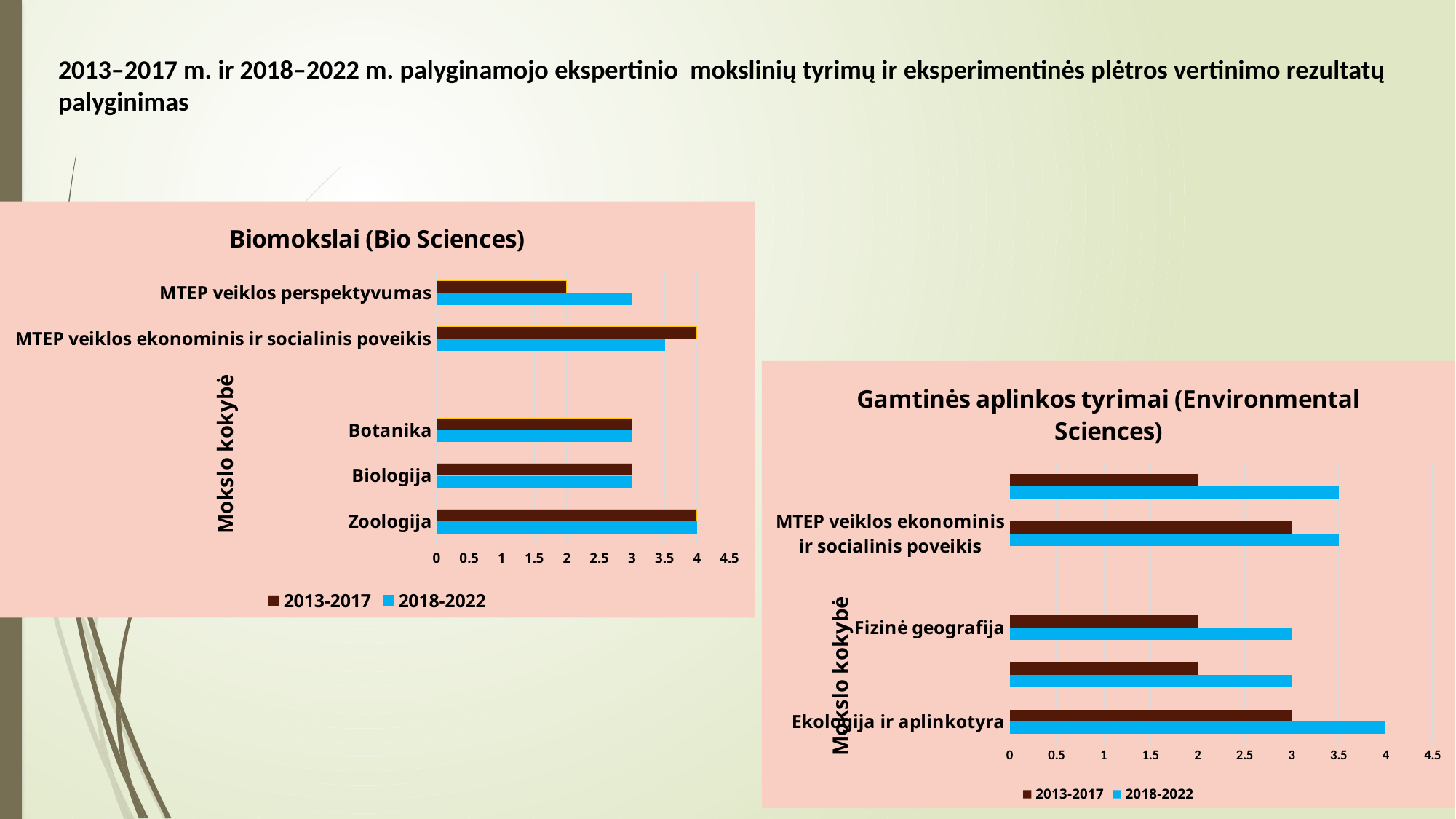
In the Gamtinės aplinkos tyrimai (Environmental Sciences) chart, what is the 2018-2022 value for Ekologija ir aplinkotyra? 4 In the Biomokslai (Bio Sciences) chart, what is the 2013-2017 value for Zoologija? 4 What type of chart is the Biomokslai (Bio Sciences) chart? bar chart In the Biomokslai (Bio Sciences) chart, which is larger for MTEP veiklos perspektyvumas: the 2013-2017 value or the 2018-2022 value? 2018-2022 In the Gamtinės aplinkos tyrimai (Environmental Sciences) chart, which is larger for MTEP veiklos ekonominis ir socialinis poveikis: the 2013-2017 value or the 2018-2022 value? 2018-2022 How many series does the legend of the Biomokslai (Bio Sciences) chart list? 2 In the Biomokslai (Bio Sciences) chart, what is the difference between the 2013-2017 and 2018-2022 values for MTEP veiklos perspektyvumas? 1 In the Biomokslai (Bio Sciences) chart, what is the 2018-2022 value for MTEP veiklos ekonominis ir socialinis poveikis? 3.5 What colour are the 2018-2022 bars in the Gamtinės aplinkos tyrimai (Environmental Sciences) chart? light blue In the Gamtinės aplinkos tyrimai (Environmental Sciences) chart, what is the 2013-2017 value for Fizinė geografija? 2 In the Biomokslai (Bio Sciences) chart, what is the 2018-2022 value for MTEP veiklos perspektyvumas? 3 How many categories are labelled on the Biomokslai (Bio Sciences) chart? 5